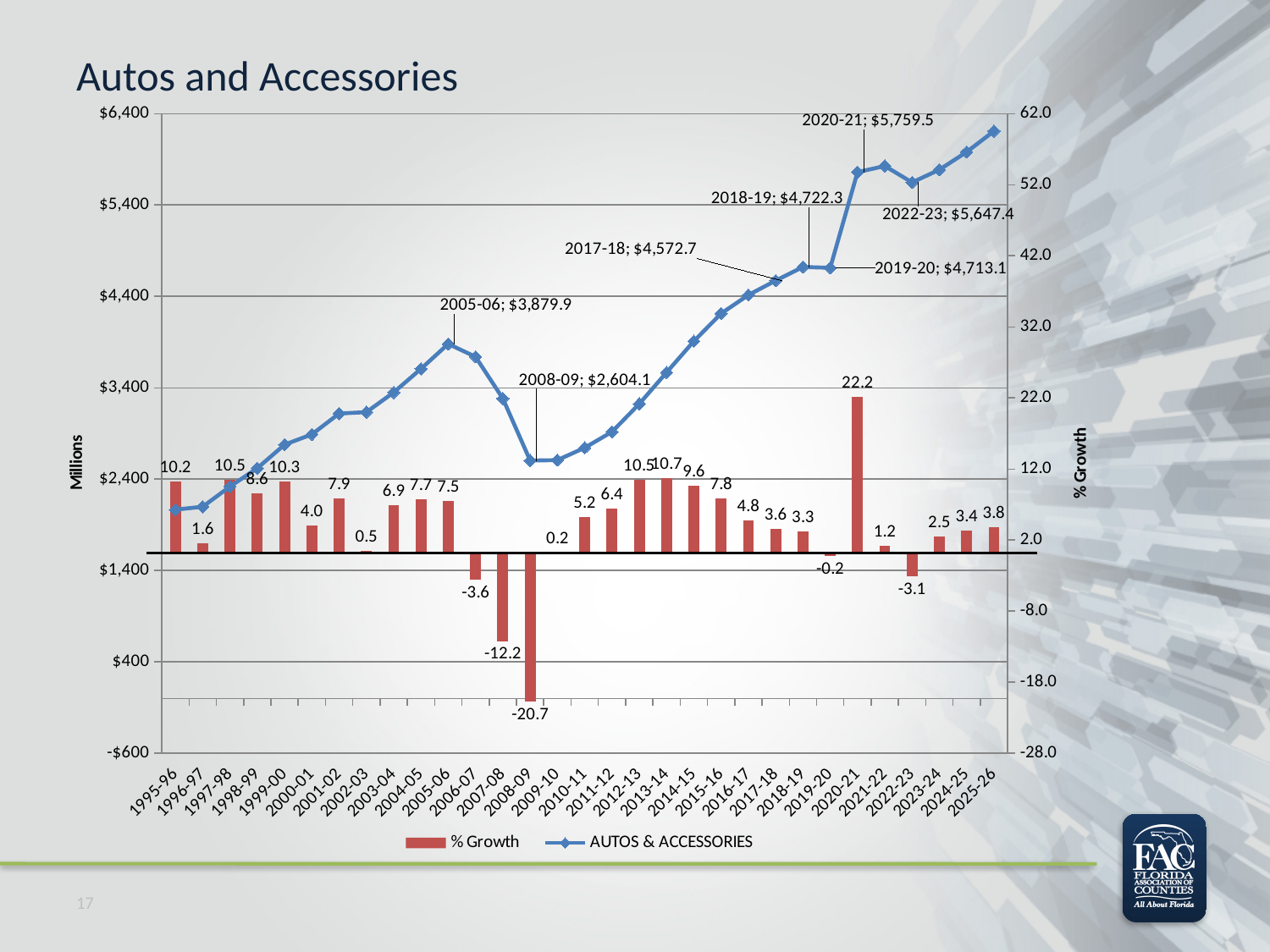
What kind of chart is this? Combined bar and line chart What is the % Growth value for 2007-08? -12.2 Which is larger, the % Growth for 2013-14 or for 2014-15? 2013-14 Which year has the highest % Growth bar? 2020-21 How many series does the legend list? 2 What is the difference between the AUTOS & ACCESSORIES values labelled for 2020-21 and 2019-20? $1,046.4 What is the AUTOS & ACCESSORIES value labelled for 2008-09? $2,604.1 How many fiscal years are shown on the x axis? 31 What is the % Growth value for 2020-21? 22.2 Which year has the lowest % Growth bar? 2008-09 Is the AUTOS & ACCESSORIES value for 2025-26 greater or less than $5,400? greater What is the title of the chart? Autos and Accessories